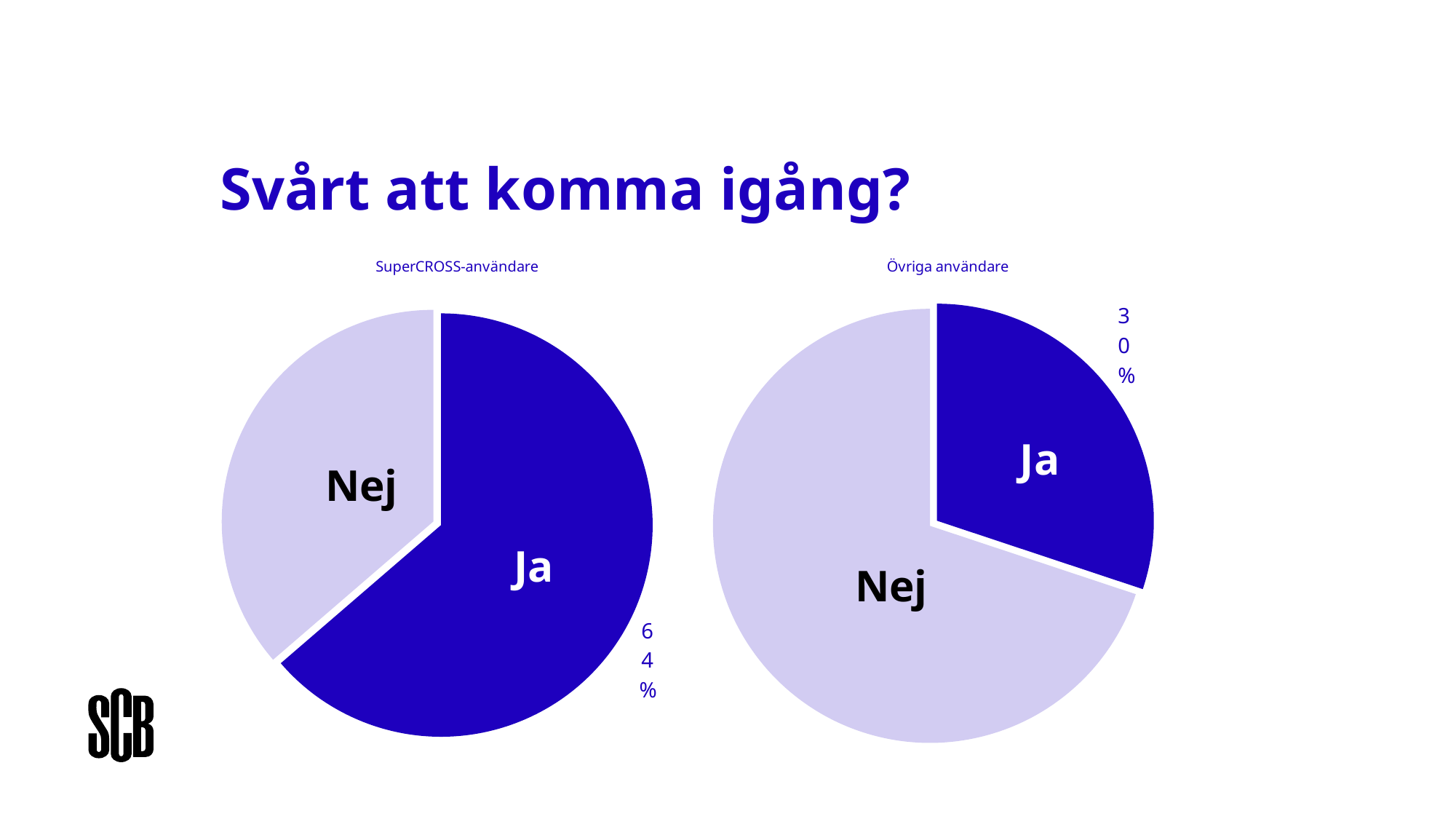
How many slices does the Övriga användare pie chart have? 2 In the Övriga användare pie chart, which slice is the smallest? Ja What is the title of the slide above the two pie charts? Svårt att komma igång? In the Övriga användare pie chart, what percentage is shown for Ja? 30% In the SuperCROSS-användare pie chart, what percentage is shown for Ja? 64% Which chart shows a larger share for Ja, SuperCROSS-användare or Övriga användare? SuperCROSS-användare What kind of chart is used for SuperCROSS-användare? Pie chart In the SuperCROSS-användare pie chart, what share of the pie does the Ja slice represent? 64% In the Övriga användare pie chart, which slice is coloured dark blue? Ja In the Övriga användare pie chart, which slice is the largest? Nej What is the difference in percentage points between the Ja share for SuperCROSS-användare and the Ja share for Övriga användare? 34 percentage points In the SuperCROSS-användare pie chart, which slice is the largest? Ja